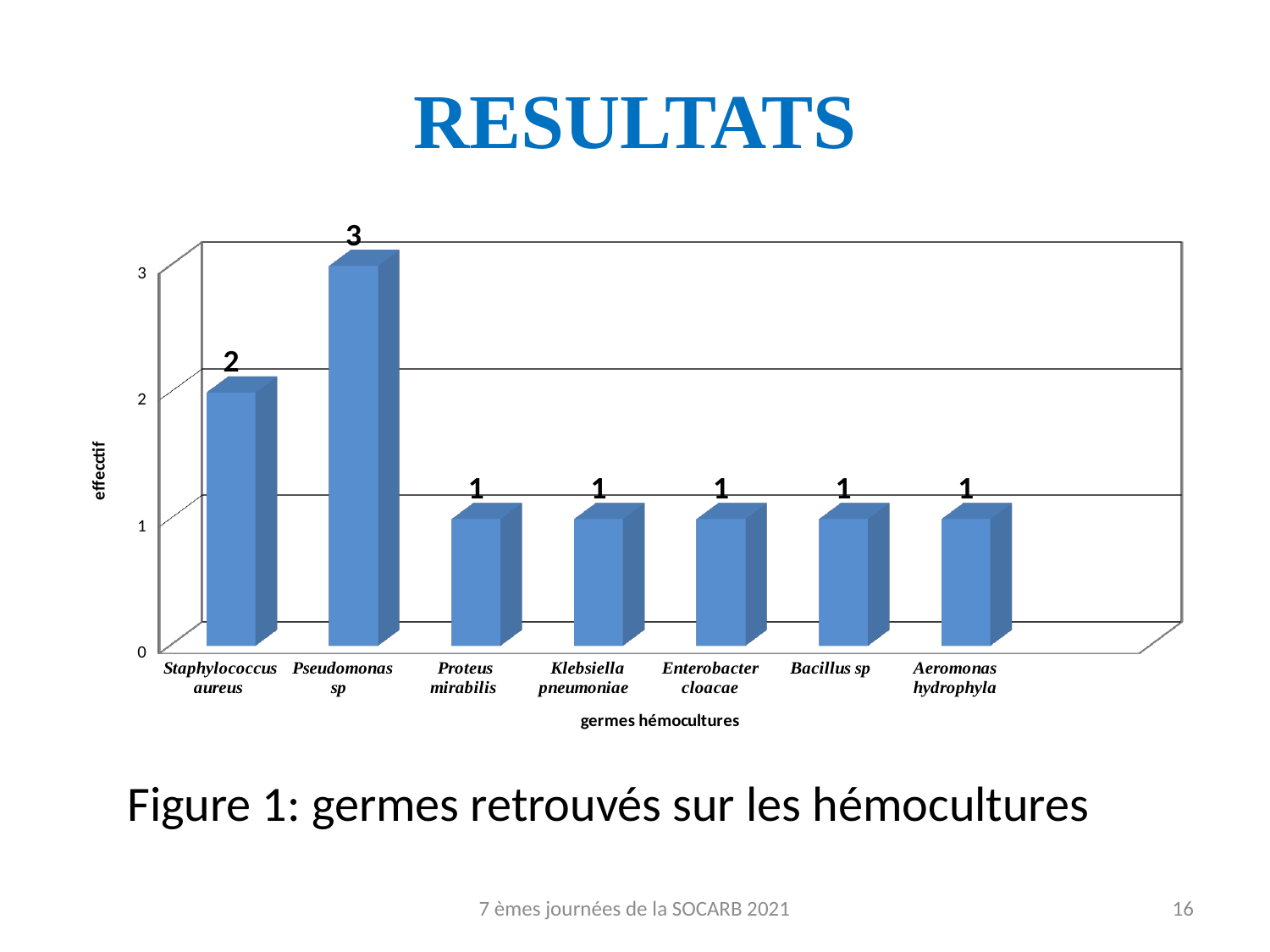
Which is larger, the value for Staphylococcus aureus or the value for Proteus mirabilis? Staphylococcus aureus How many germ categories are shown on the x axis? 7 Which germ has the highest value? Pseudomonas sp What is the label of the y axis? effectif What is the value for Pseudomonas sp? 3 What is the difference between the values for Staphylococcus aureus and Bacillus sp? 1 What kind of chart is shown? bar chart What is the value for Klebsiella pneumoniae? 1 What is the label of the x axis? germes hémocultures Is the value for Pseudomonas sp greater or less than 2? greater What is the difference between the values for Pseudomonas sp and Staphylococcus aureus? 1 What is the value for Staphylococcus aureus? 2